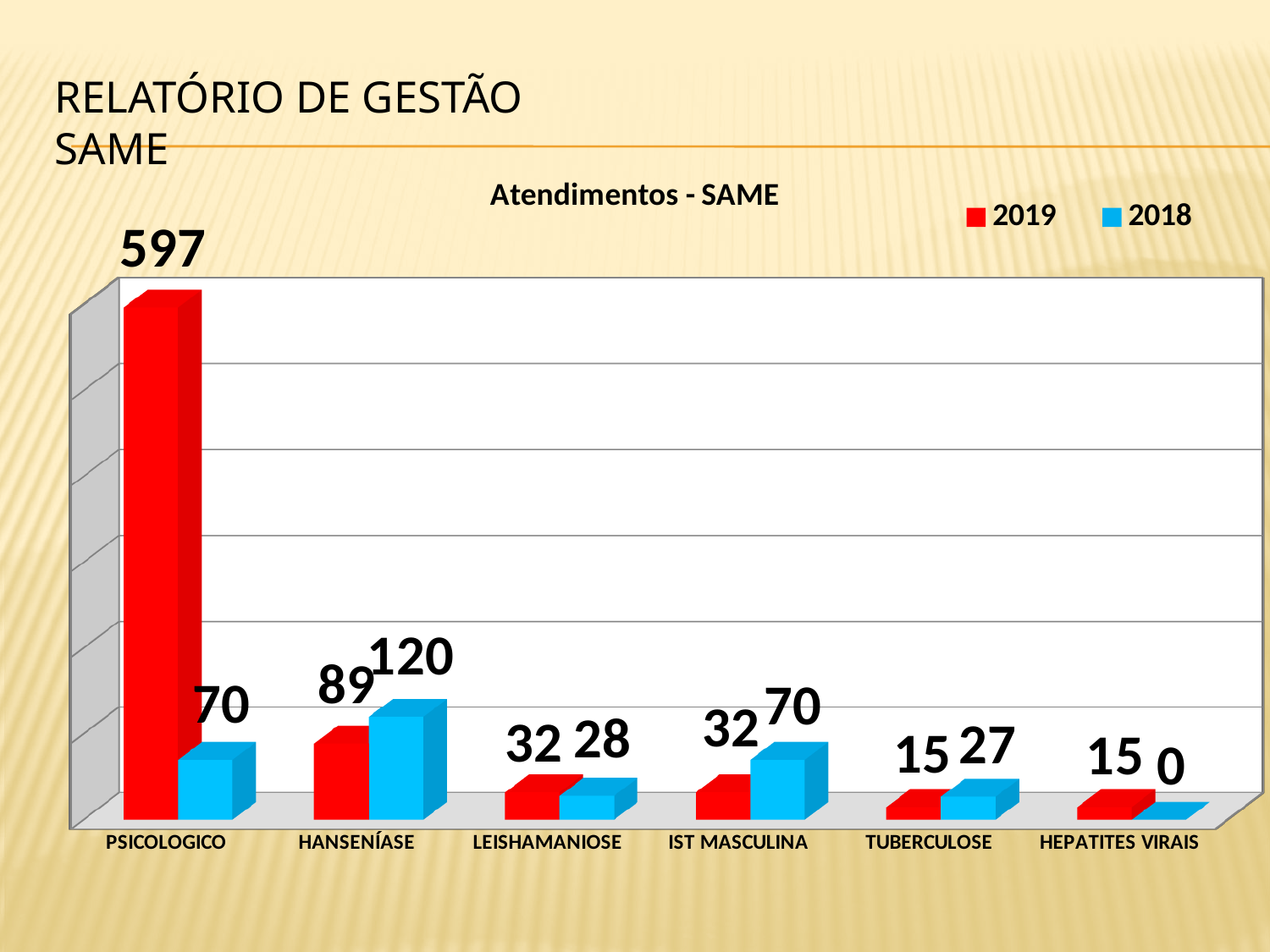
For TUBERCULOSE, which year has the larger value, 2019 or 2018? 2018 What is the 2018 value for HEPATITES VIRAIS? 0 What is the difference between the 2019 and 2018 values for PSICOLOGICO? 527 How many categories are shown on the x axis? 6 Which category has the highest 2019 value? PSICOLOGICO What is the 2019 value for PSICOLOGICO? 597 How many series does the legend list? 2 What is the title of the chart? Atendimentos - SAME What is the difference between the 2018 and 2019 values for IST MASCULINA? 38 What is the 2018 value for HANSENÍASE? 120 What kind of chart is shown? Bar chart Which category has the lowest 2018 value? HEPATITES VIRAIS